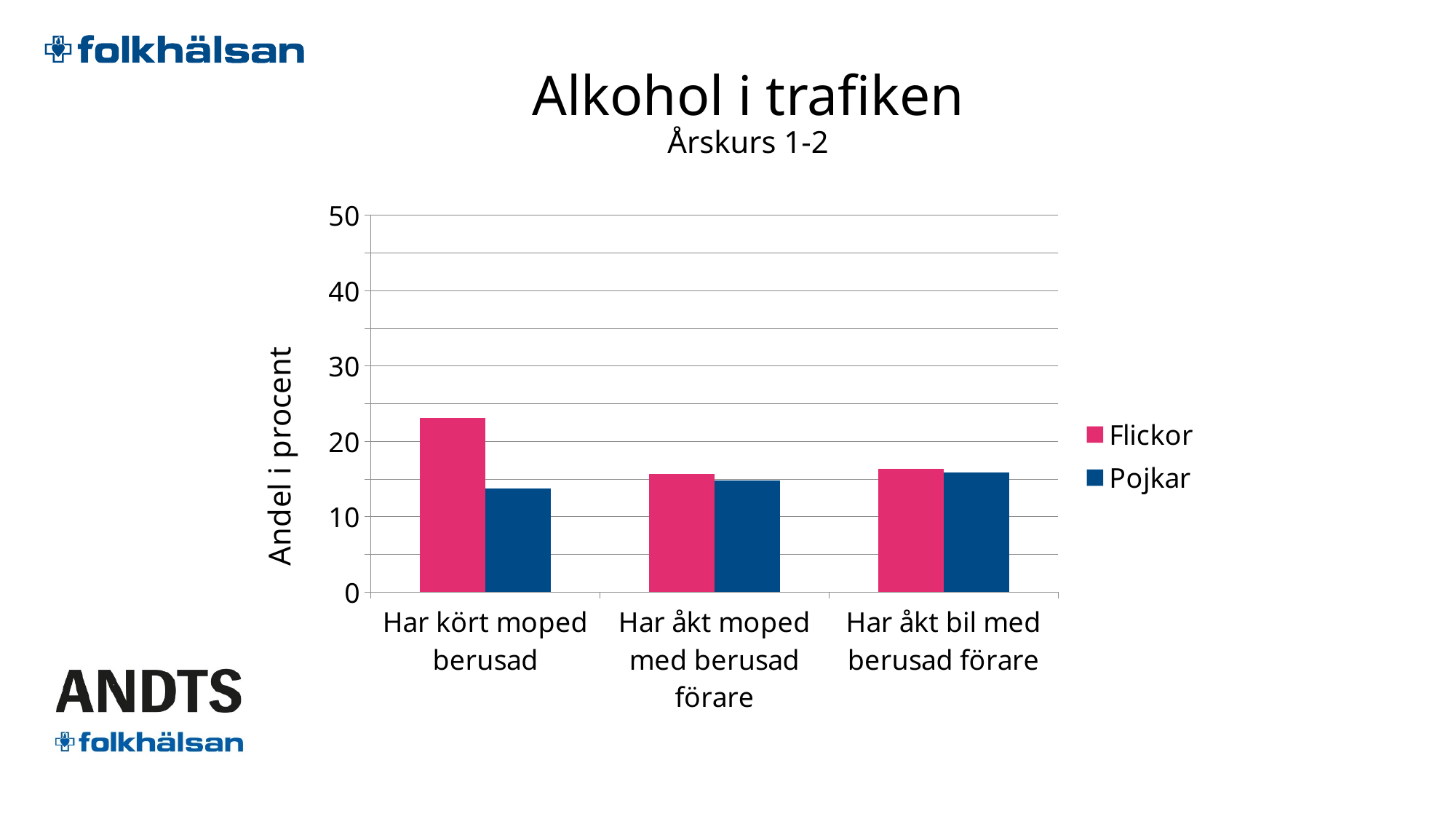
What kind of chart is shown on the slide? bar chart Which category has the highest value for Flickor? Har kört moped berusad Which series is shown in pink in the chart's legend? Flickor How many series does the chart's legend list? 2 Is the value for Pojkar in 'Har kört moped berusad' greater or less than 20? less How many categories are shown on the x axis of the chart? 3 Is the value for Flickor in 'Har åkt moped med berusad förare' greater or less than 10? greater Is the value for Flickor in 'Har kört moped berusad' greater or less than 30? less What is the label on the y axis of the chart? Andel i procent For the category 'Har kört moped berusad', which series has the larger value, Flickor or Pojkar? Flickor